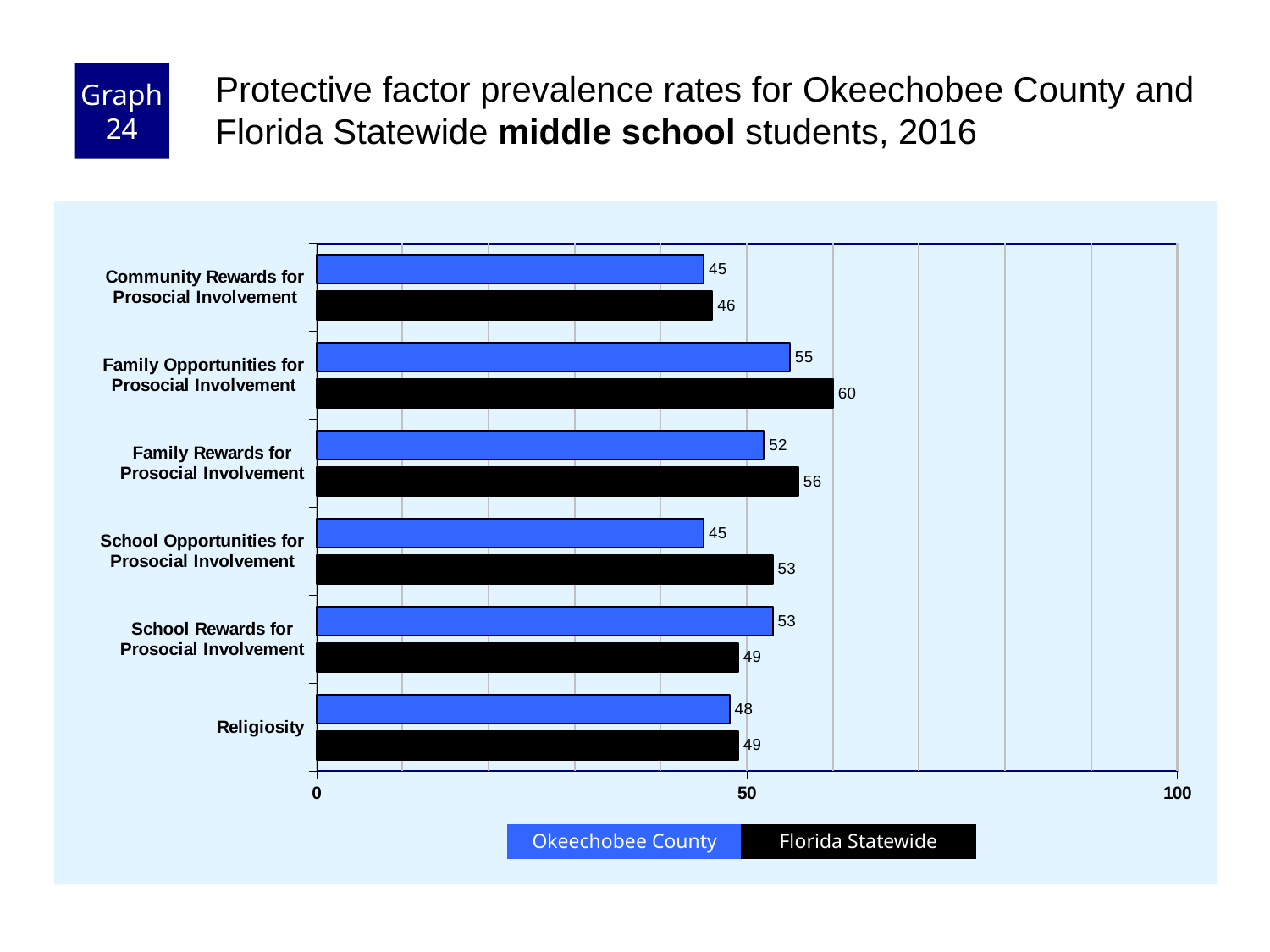
Which protective factor has the lowest Florida Statewide value? Community Rewards for Prosocial Involvement How many protective factors are shown on the chart? 6 Is the Florida Statewide value for Family Opportunities for Prosocial Involvement greater or less than 50? greater What is the Okeechobee County value for Religiosity? 48 How many series does the legend list? 2 What is the Okeechobee County value for Family Opportunities for Prosocial Involvement? 55 For School Rewards for Prosocial Involvement, which is larger: the Okeechobee County value or the Florida Statewide value? Okeechobee County Which protective factor has the highest Florida Statewide value? Family Opportunities for Prosocial Involvement What is the difference between the Florida Statewide and Okeechobee County values for Family Opportunities for Prosocial Involvement? 5 What is the Florida Statewide value for School Opportunities for Prosocial Involvement? 53 What type of chart is shown on the slide? Bar chart What is the difference between the Florida Statewide and Okeechobee County values for School Opportunities for Prosocial Involvement? 8